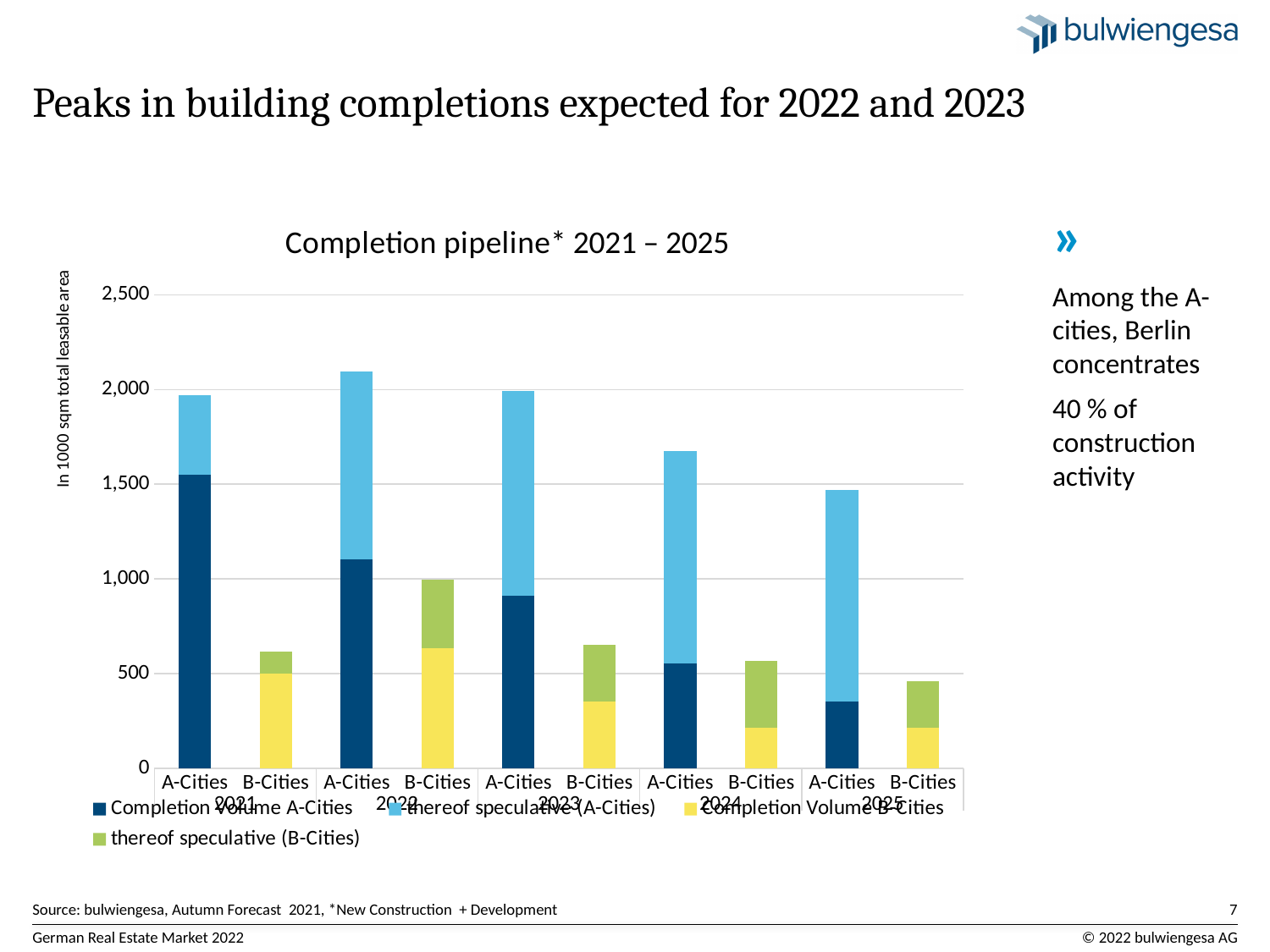
Is the total value for A-Cities in 2022 greater or less than 2,000? greater Which is larger in 2021, the total for A-Cities or the total for B-Cities? A-Cities Which bar has the highest total value? A-Cities 2022 What kind of chart is shown on the slide? Stacked bar chart How many series does the legend list? 4 Does the Completion Volume A-Cities segment rise or fall from 2021 to 2025? fall Is the total value for A-Cities in 2024 greater or less than 1,500? greater Which bar has the lowest total value? B-Cities 2025 Is the total value for B-Cities in 2025 greater or less than 500? less What is the title of the chart? Completion pipeline* 2021 – 2025 How many bars are plotted in the chart? 10 What is the label of the vertical axis? In 1000 sqm total leasable area